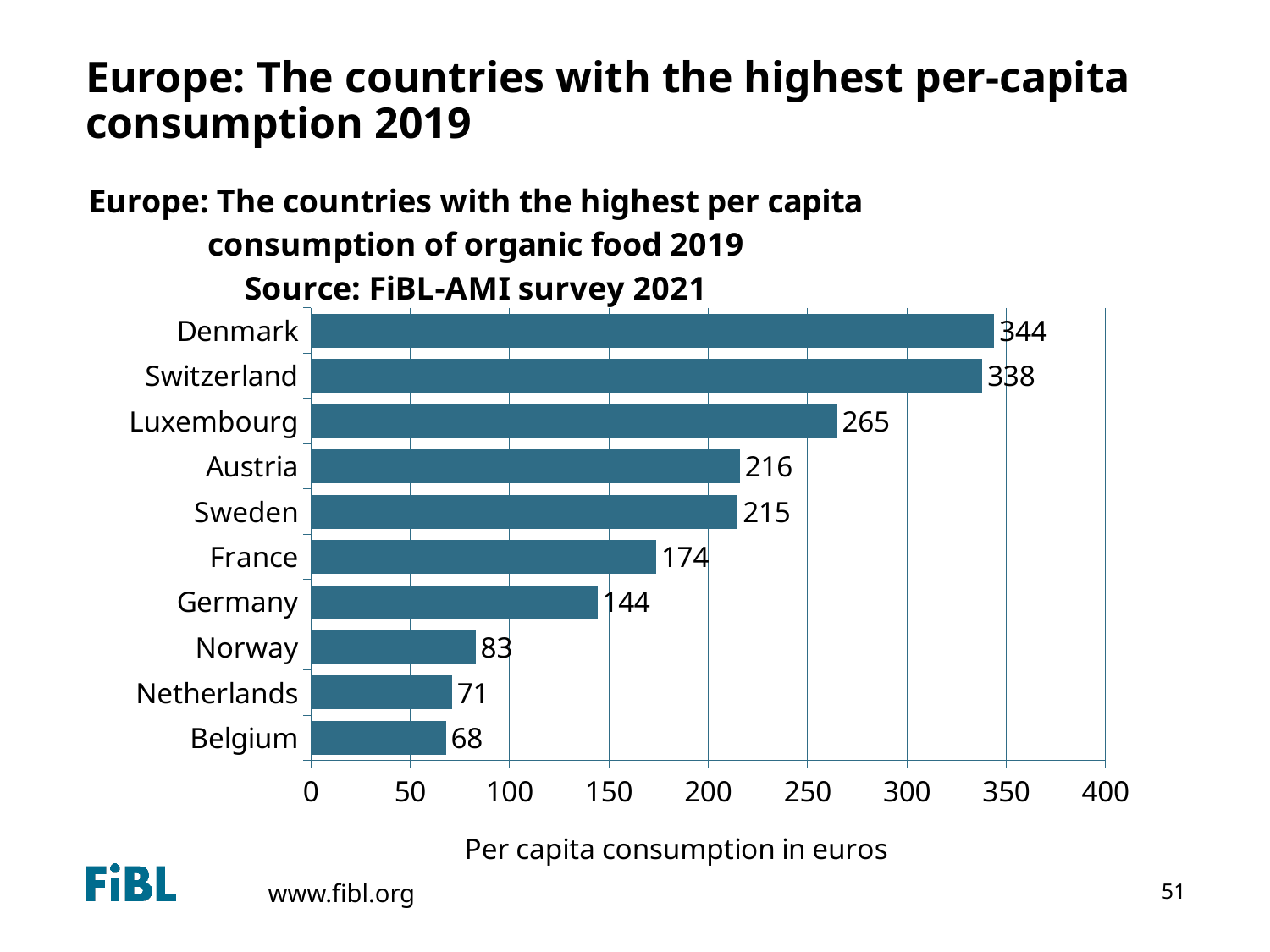
What is the label of the horizontal axis? Per capita consumption in euros Which country has the highest per capita consumption? Denmark Is the value for Norway greater or less than 100? less What is the per capita consumption for France? 174 Which country has the lowest per capita consumption? Belgium What is the per capita consumption for Netherlands? 71 What kind of chart is shown on the slide? Bar chart What is the difference between the values for Luxembourg and Germany? 121 What is the per capita consumption for Denmark? 344 Which has a larger value, Switzerland or Luxembourg? Switzerland How many countries are shown in the chart? 10 What source is cited in the chart title? FiBL-AMI survey 2021